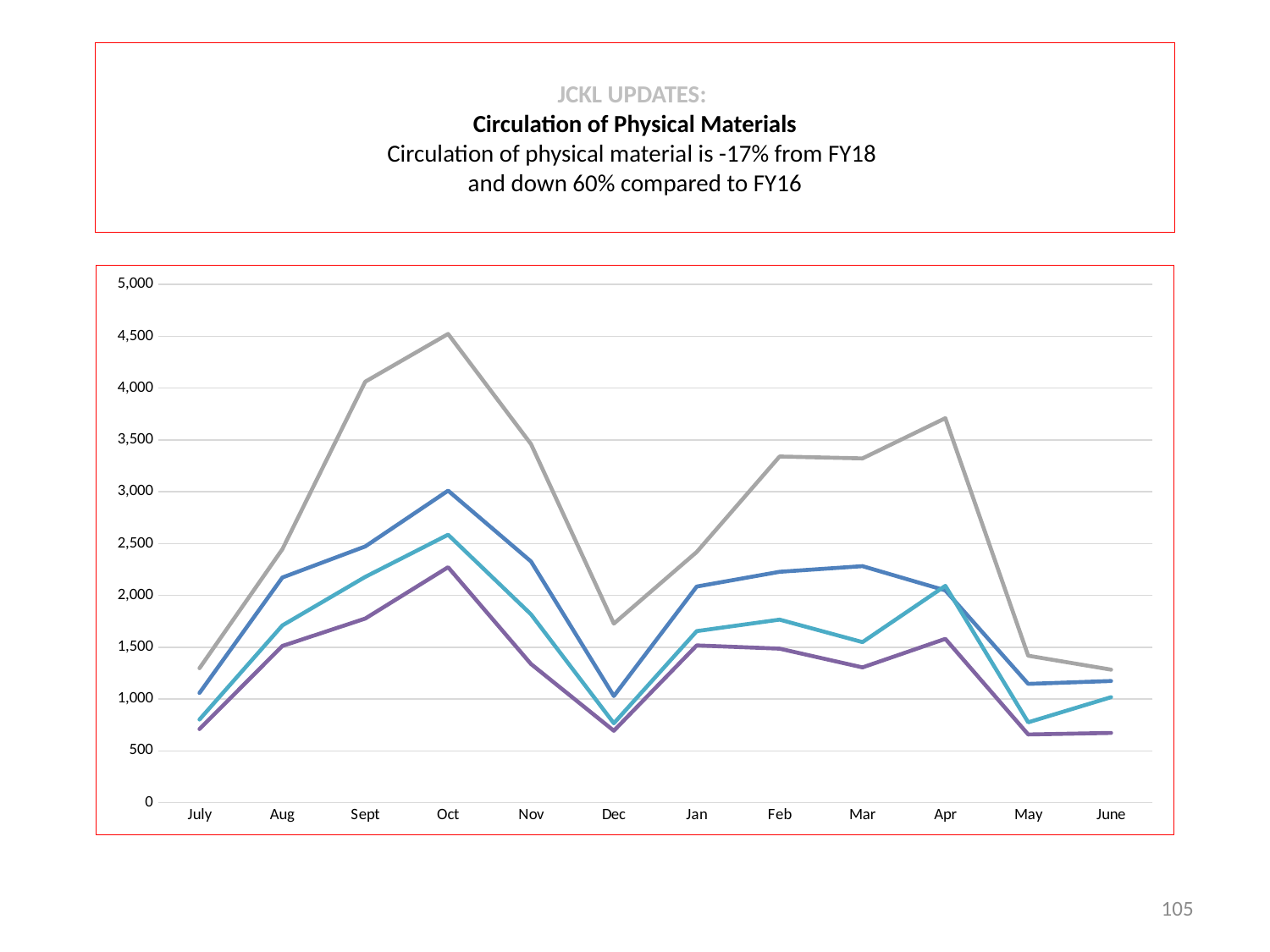
What is the highest value shown on the y axis of the chart? 5,000 What kind of chart is shown on the slide? line chart Is the value of the purple line in Dec greater or less than 1,000? less How many months are shown along the x axis of the chart? 12 In Apr, which line has the higher value, the gray line or the blue line? gray line In which month does the gray line reach its highest value? Oct Is the value of the gray line in Dec greater or less than 2,000? less Is the value of the blue line in Oct greater or less than 2,500? greater How many lines are plotted on the chart? 4 In which month does the blue line reach its highest value? Oct In Mar, which line has the higher value, the blue line or the teal line? blue line